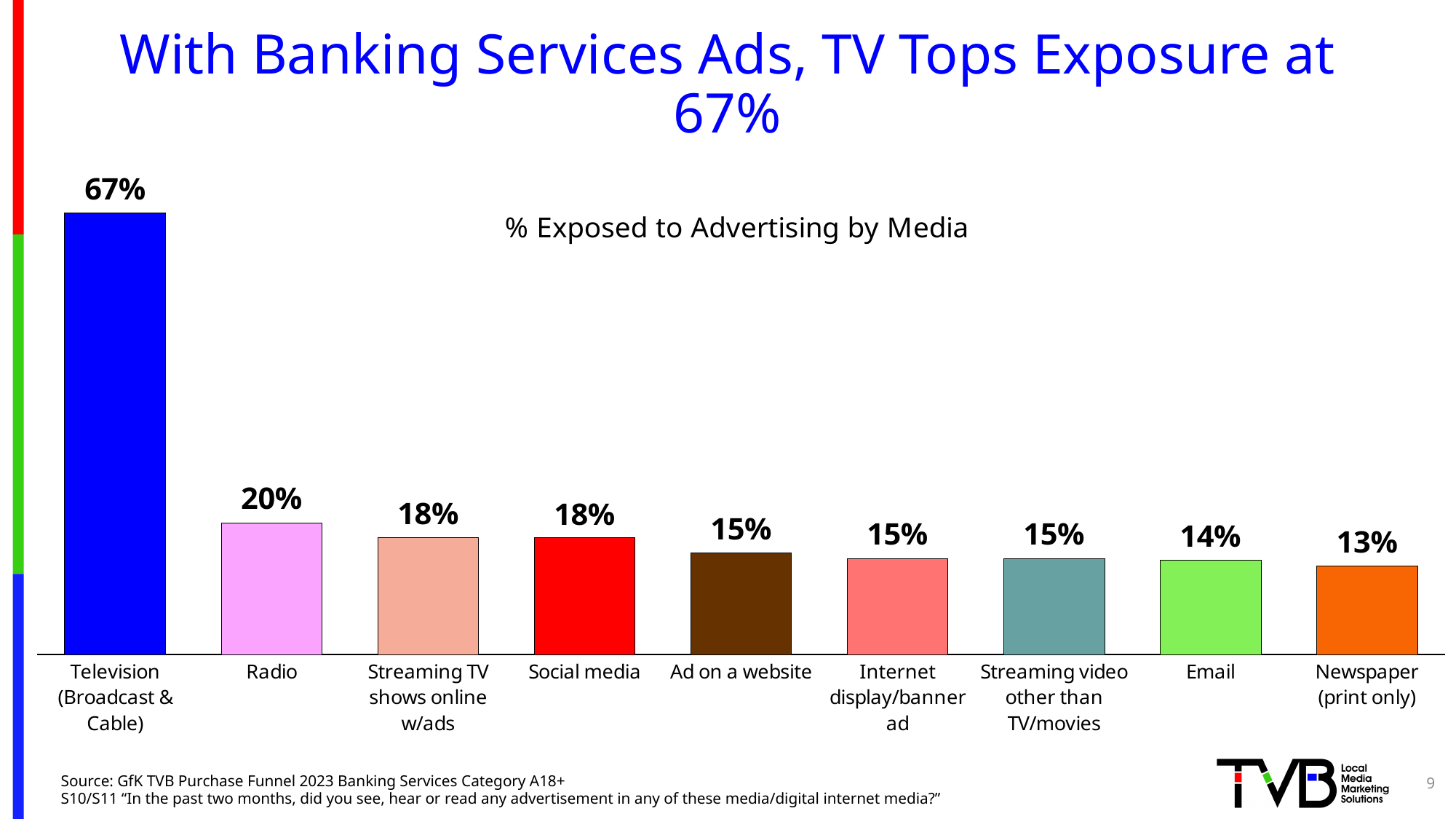
How many media categories are shown in the chart? 9 Which is larger, the value for Social media or the value for Email? Social media What is the value for Email? 14% Which media category has the highest exposure value? Television (Broadcast & Cable) What is the difference between the Television (Broadcast & Cable) value and the Radio value? 47 percentage points What is the value shown for Radio? 20% What percentage were exposed to banking services advertising on Television (Broadcast & Cable)? 67% What is the title of the chart? % Exposed to Advertising by Media What is the difference between the Radio value and the Newspaper (print only) value? 7 percentage points Which media category has the lowest exposure value? Newspaper (print only) What type of chart is shown on the slide? Bar chart What percentage is shown for Newspaper (print only)? 13%